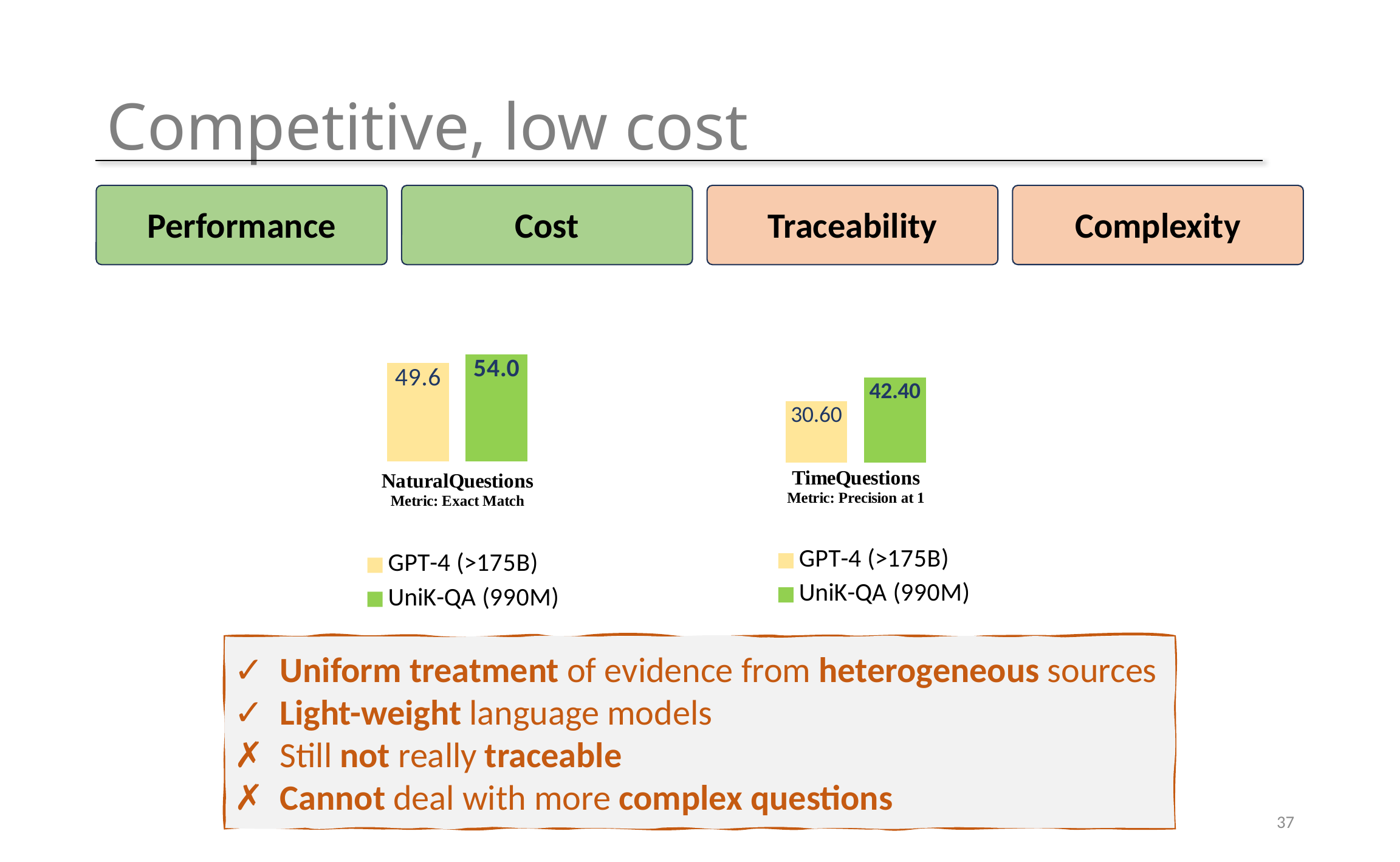
In the TimeQuestions chart, is the value for GPT-4 (>175B) larger or smaller than the value for UniK-QA (990M)? smaller In the NaturalQuestions chart, what is the value for UniK-QA (990M)? 54.0 In the NaturalQuestions chart, what is the value for GPT-4 (>175B)? 49.6 How many series does the legend of the NaturalQuestions chart list? 2 What kind of chart is the TimeQuestions chart? bar chart In the TimeQuestions chart, what is the value for GPT-4 (>175B)? 30.60 In the TimeQuestions chart, what is the difference between the UniK-QA (990M) and GPT-4 (>175B) values? 11.80 In the NaturalQuestions chart, what is the difference between the UniK-QA (990M) and GPT-4 (>175B) values? 4.4 In the TimeQuestions chart, what is the value for UniK-QA (990M)? 42.40 In the NaturalQuestions chart, which series has the higher value? UniK-QA (990M) What metric is stated under the TimeQuestions chart? Precision at 1 In the TimeQuestions chart, which series has the lower value? GPT-4 (>175B)